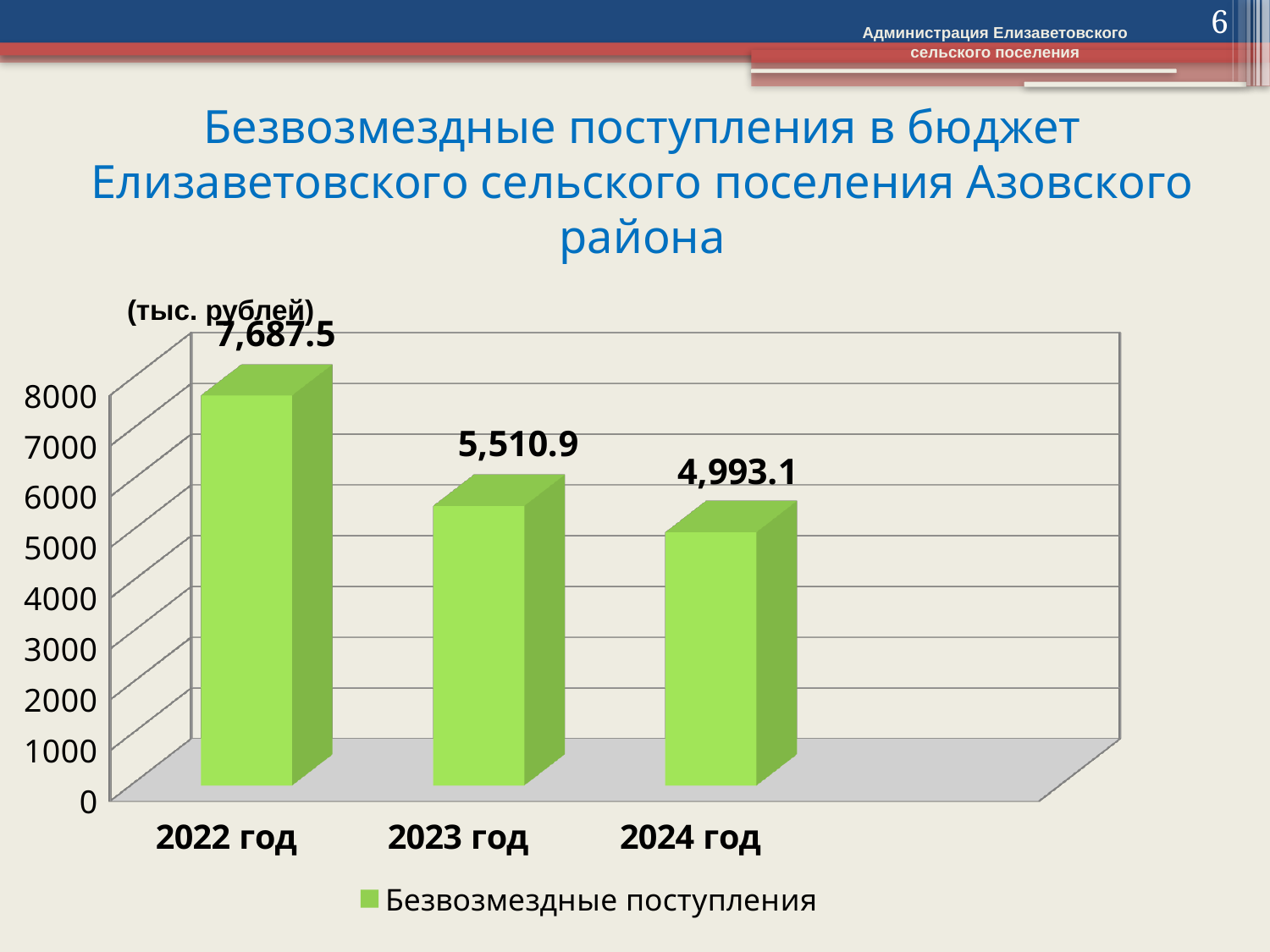
What is the value for 2024 год? 4,993.1 Which is larger, the value for 2023 год or 2024 год? 2023 год What is the difference between the values for 2022 год and 2023 год? 2,176.6 Which year has the lowest value? 2024 год Which year has the highest value? 2022 год What is the difference between the values for 2023 год and 2024 год? 517.8 Do the values rise or fall from 2022 год to 2024 год? fall What is the value for 2023 год? 5,510.9 How many years are shown on the chart? 3 Is the value for 2024 год greater or less than 5000? less What kind of chart is shown on the slide? bar chart What is the value for 2022 год? 7,687.5